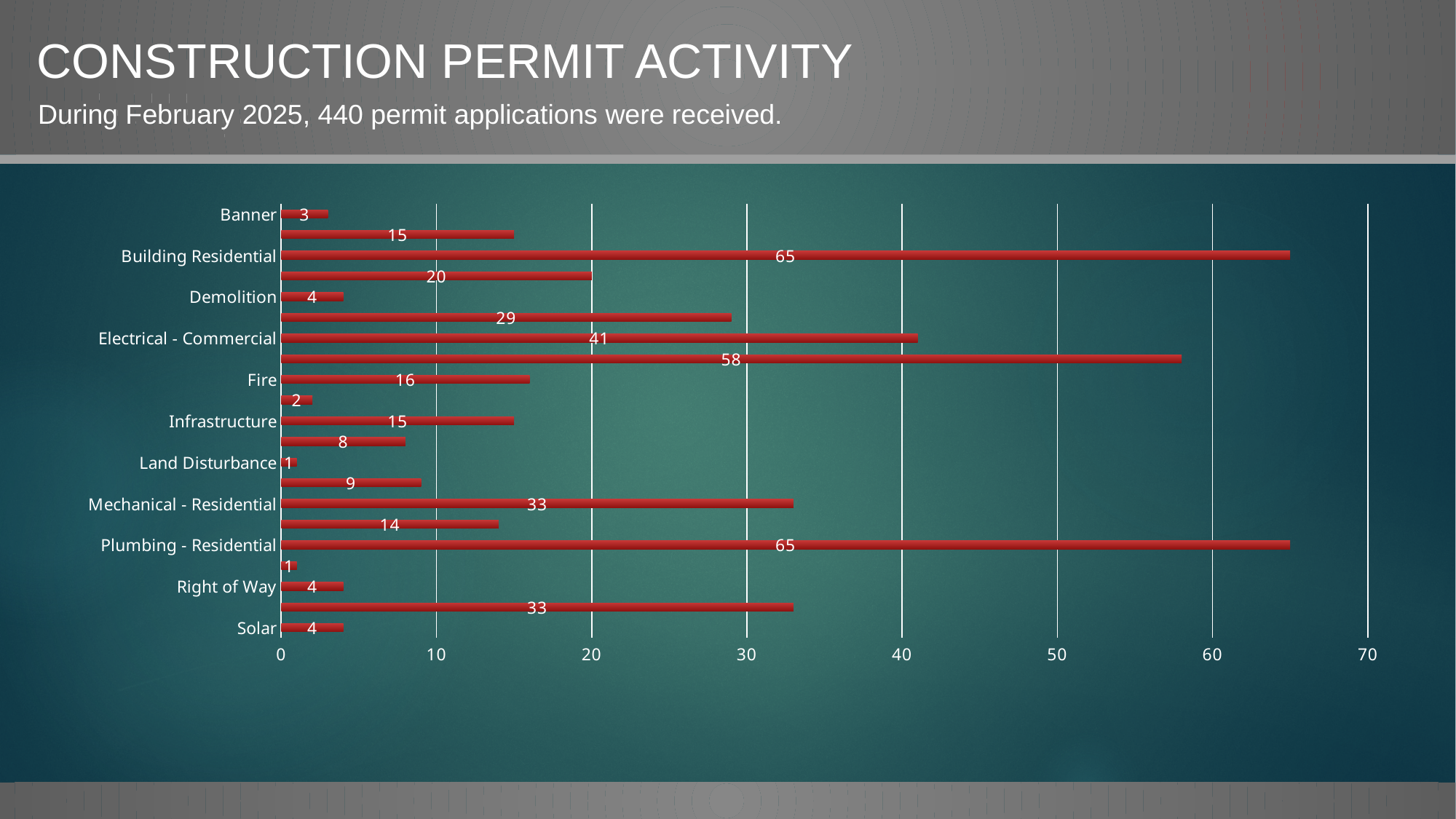
What is the value for Fire? 16 Is the value for Electrical - Commercial greater or less than 40? greater What is the value for Building Residential? 65 According to the slide subtitle, how many permit applications were received during February 2025? 440 What is the value for Mechanical - Residential? 33 Which has a larger value, Demolition or Infrastructure? Infrastructure What is the value for Banner? 3 What is the difference between the values for Electrical - Commercial and Fire? 25 What kind of chart is shown on the slide? Bar chart Do Building Residential and Plumbing - Residential have the same value? Yes, both are 65 What is the value for Land Disturbance? 1 What is the value for Electrical - Commercial? 41